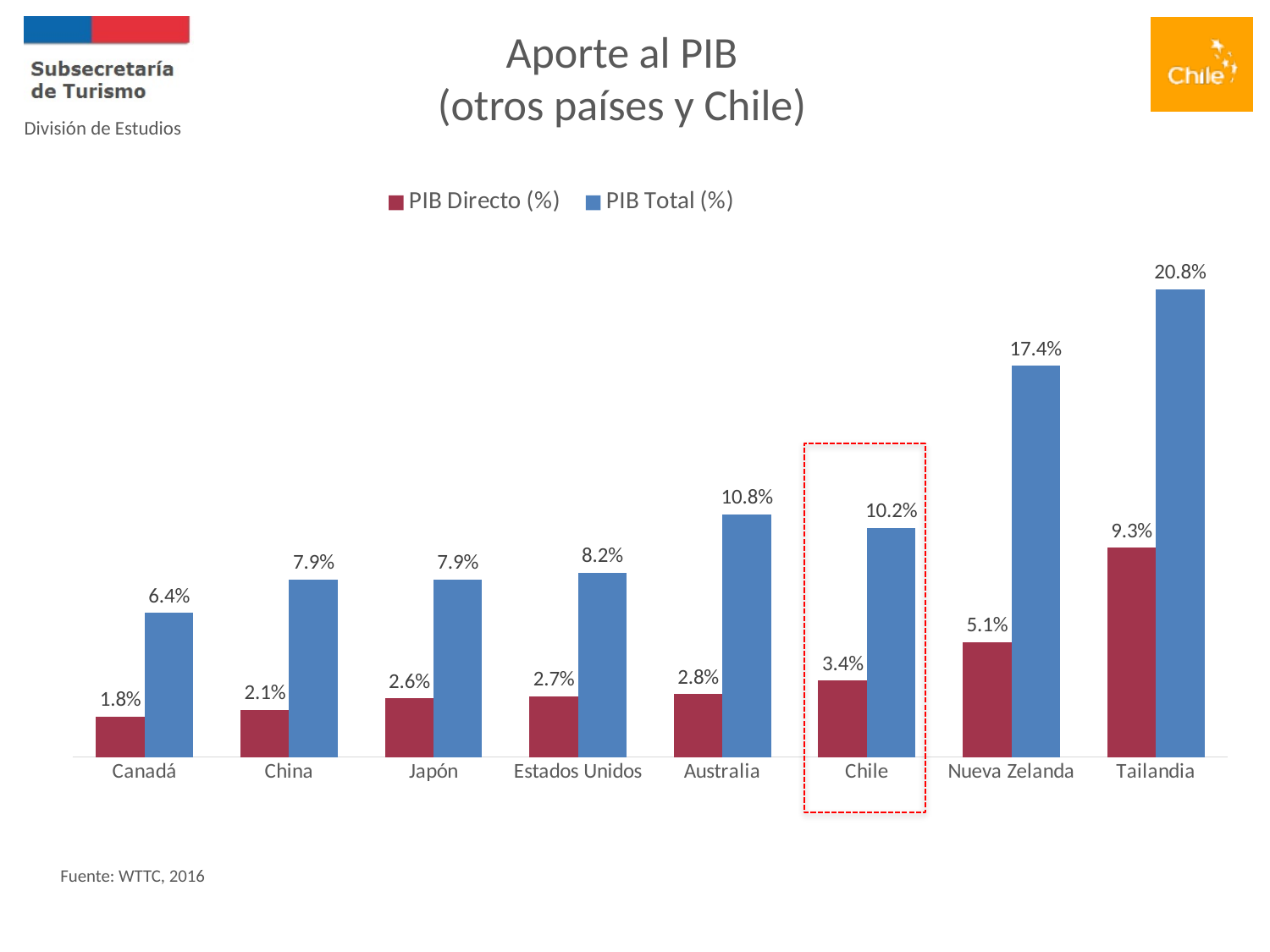
How many series does the legend list? 2 Which country has the lowest PIB Directo (%)? Canadá What is the PIB Directo (%) value for Nueva Zelanda? 5.1% What is the difference in PIB Total (%) between Tailandia and Nueva Zelanda? 3.4% What is the PIB Directo (%) value for Canadá? 1.8% What is the PIB Total (%) value for Chile? 10.2% Which country has the highest PIB Total (%)? Tailandia Which is larger, the PIB Total (%) for Australia or for Chile? Australia How many countries are shown on the x axis? 8 Which country is highlighted with a red dashed box? Chile What is the difference between the PIB Total (%) and PIB Directo (%) for Chile? 6.8% What kind of chart is shown on the slide? Bar chart